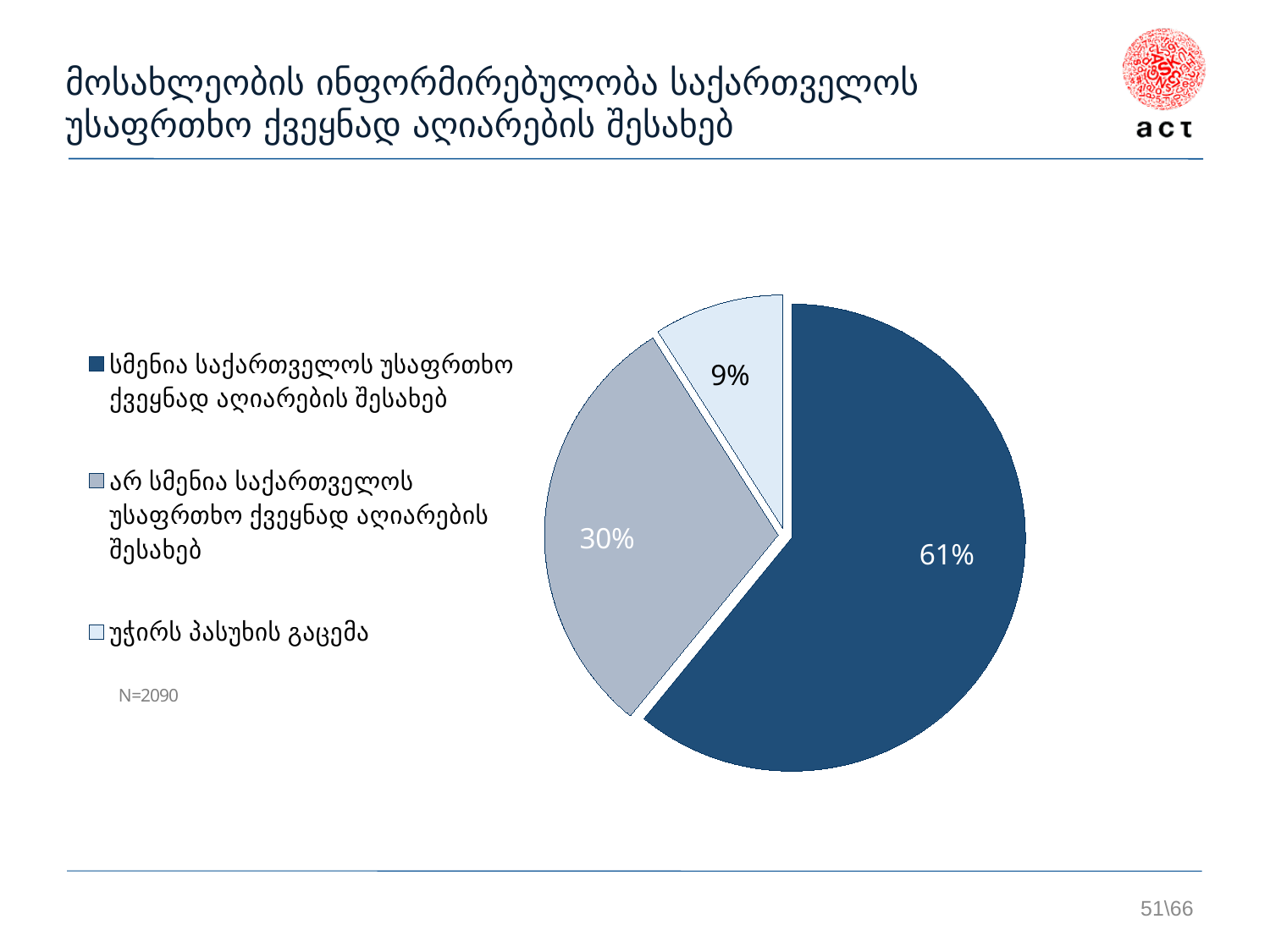
How many entries does the legend list? 3 What percentage is shown for the slice "უჭირს პასუხის გაცემა"? 9% Which is larger: the slice for "არ სმენია საქართველოს უსაფრთხო ქვეყნად აღიარების შესახებ" or the slice for "უჭირს პასუხის გაცემა"? არ სმენია საქართველოს უსაფრთხო ქვეყნად აღიარების შესახებ What is the difference in percentage points between the largest slice (61%) and the slice labelled 30%? 31 Which category has the largest share of the pie? სმენია საქართველოს უსაფრთხო ქვეყნად აღიარების შესახებ What colour is the slice labelled 61%? dark blue Which category has the smallest share of the pie? უჭირს პასუხის გაცემა What percentage is shown for the slice "არ სმენია საქართველოს უსაფრთხო ქვეყნად აღიარების შესახებ"? 30% How many slices does the pie chart have? 3 What percentage is shown for the slice "სმენია საქართველოს უსაფრთხო ქვეყნად აღიარების შესახებ"? 61% What kind of chart is shown on the slide? pie chart What sample size (N) is stated on the slide? N=2090